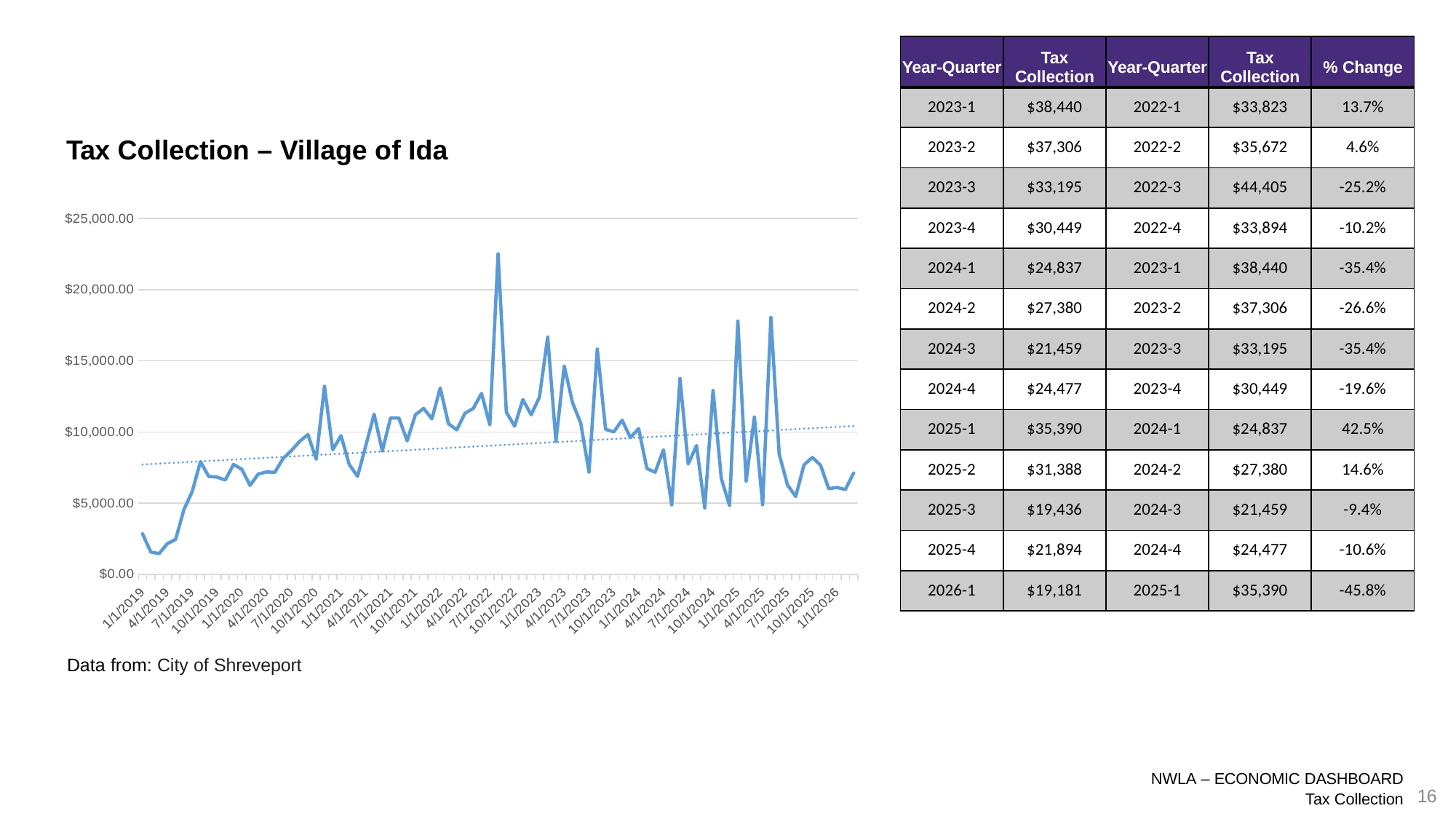
Is the value at 4/1/2019 greater or less than $5,000? less Is the highest point on the line greater or less than $20,000? greater What is the highest value shown on the chart's vertical axis? $25,000.00 Does the dotted trend line rise or fall from left to right? rise In which year does the line reach its lowest value? 2019 In which year does the line reach its highest value? 2022 Is the value at 1/1/2020 greater or less than $10,000? less What is the title of the chart? Tax Collection – Village of Ida What kind of chart is shown on the slide? line chart Which is larger, the value at 1/1/2019 or the value at 1/1/2026? 1/1/2026